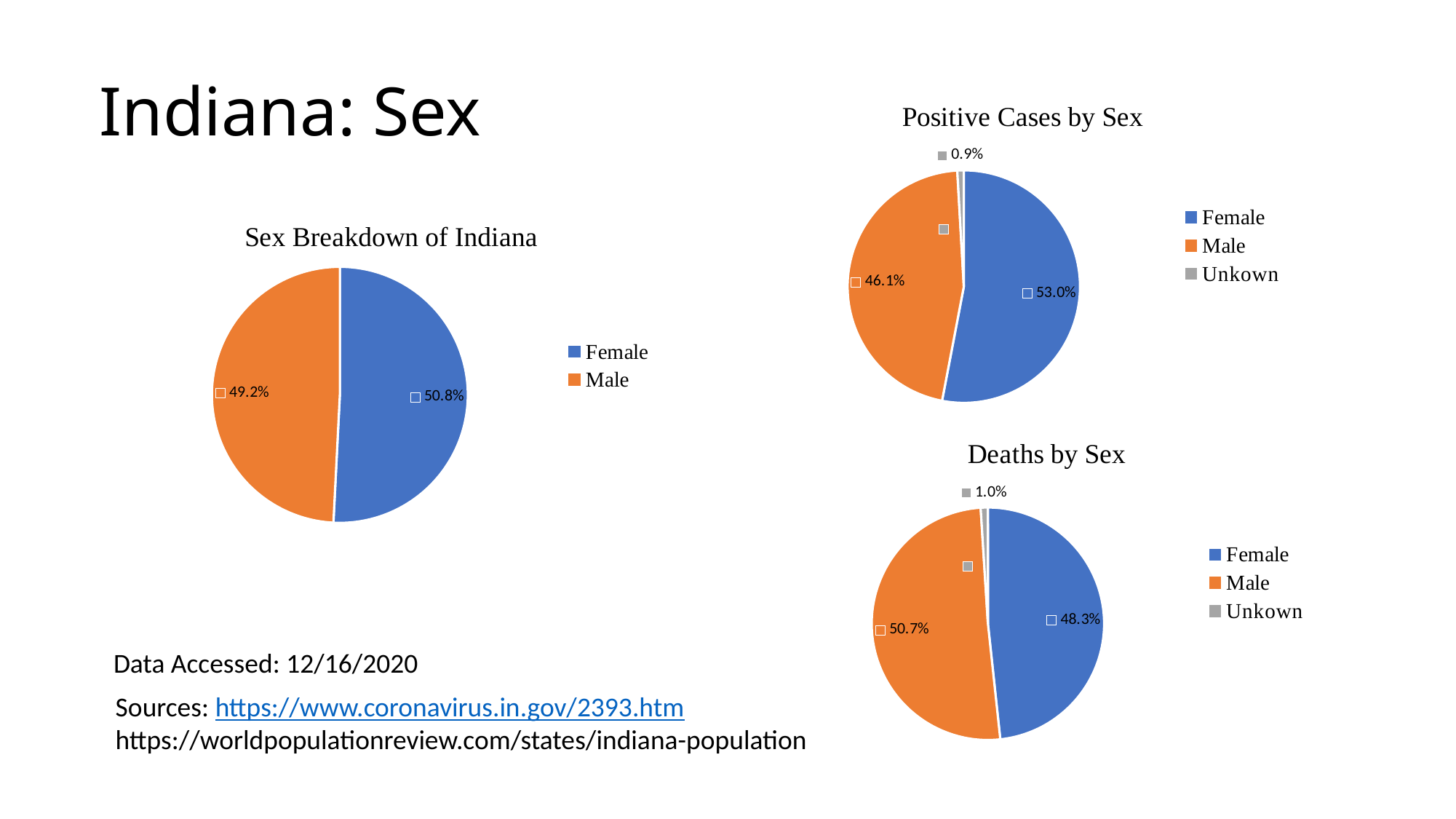
In the 'Positive Cases by Sex' chart, which category has the smallest slice? Unknown In the 'Deaths by Sex' chart, what percentage is Female? 48.3% In the 'Positive Cases by Sex' chart, what percentage is Male? 46.1% What type of chart is 'Sex Breakdown of Indiana'? Pie chart How many slices does the 'Deaths by Sex' chart have? 3 In the 'Sex Breakdown of Indiana' chart, what share is Male? 49.2% In the 'Positive Cases by Sex' chart, what percentage is Unknown? 0.9% In the 'Positive Cases by Sex' chart, what percentage is Female? 53.0% In the 'Deaths by Sex' chart, which category has the largest slice? Male In the 'Positive Cases by Sex' chart, what is the difference between the Female and Male percentages? 6.9% In the 'Sex Breakdown of Indiana' chart, what share is Female? 50.8% In the 'Deaths by Sex' chart, what percentage is Male? 50.7%